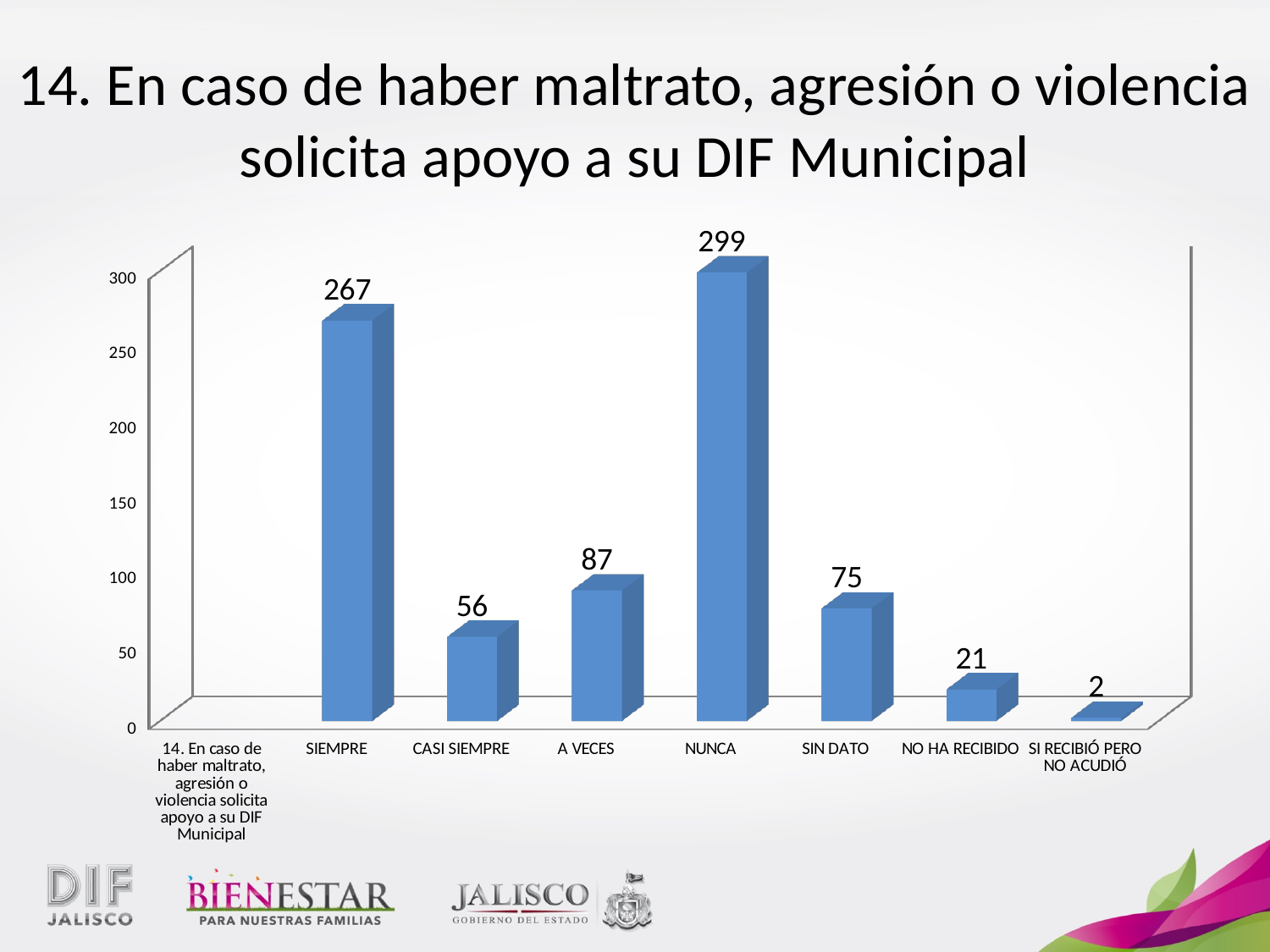
How many bars are plotted in the chart? 7 What is the value for SI RECIBIÓ PERO NO ACUDIÓ? 2 What is the value for NUNCA? 299 Which category has the highest value? NUNCA What is the difference between the values for NUNCA and SIEMPRE? 32 Is the value for SIN DATO greater or less than 100? less What is the value for CASI SIEMPRE? 56 Which category has the lowest value? SI RECIBIÓ PERO NO ACUDIÓ What kind of chart is shown on the slide? bar chart Which is larger, the value for A VECES or the value for CASI SIEMPRE? A VECES What is the value for SIEMPRE? 267 What is the difference between the values for A VECES and SIN DATO? 12